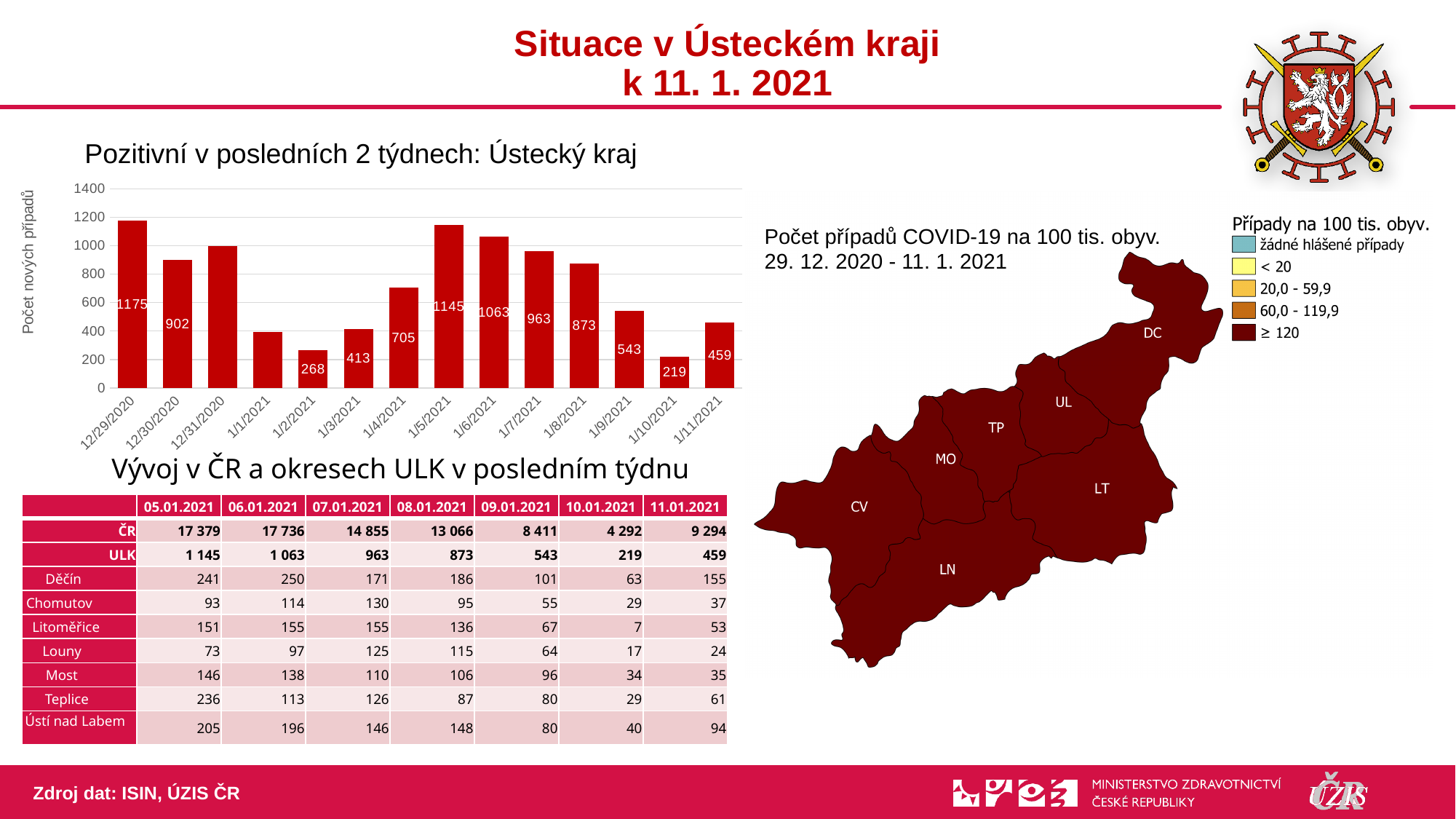
What type of chart is shown under the heading 'Pozitivní v posledních 2 týdnech: Ústecký kraj'? bar chart In the bar chart, what is the difference between the values for 1/9/2021 and 1/10/2021? 324 In the bar chart, which is larger: the value for 12/30/2020 or the value for 1/7/2021? 1/7/2021 In the bar chart, what is the value for 1/5/2021? 1145 In the bar chart, what is the value for 12/29/2020? 1175 In the bar chart, is the value for 12/31/2020 greater or less than 800? greater In the bar chart, which date has the highest value? 12/29/2020 In the bar chart, which date has the lowest value? 1/10/2021 In the bar chart, what is the difference between the values for 1/6/2021 and 1/7/2021? 100 In the bar chart, what is the value for 1/10/2021? 219 What is the y-axis title of the bar chart? Počet nových případů How many dates are shown on the x axis of the bar chart? 14